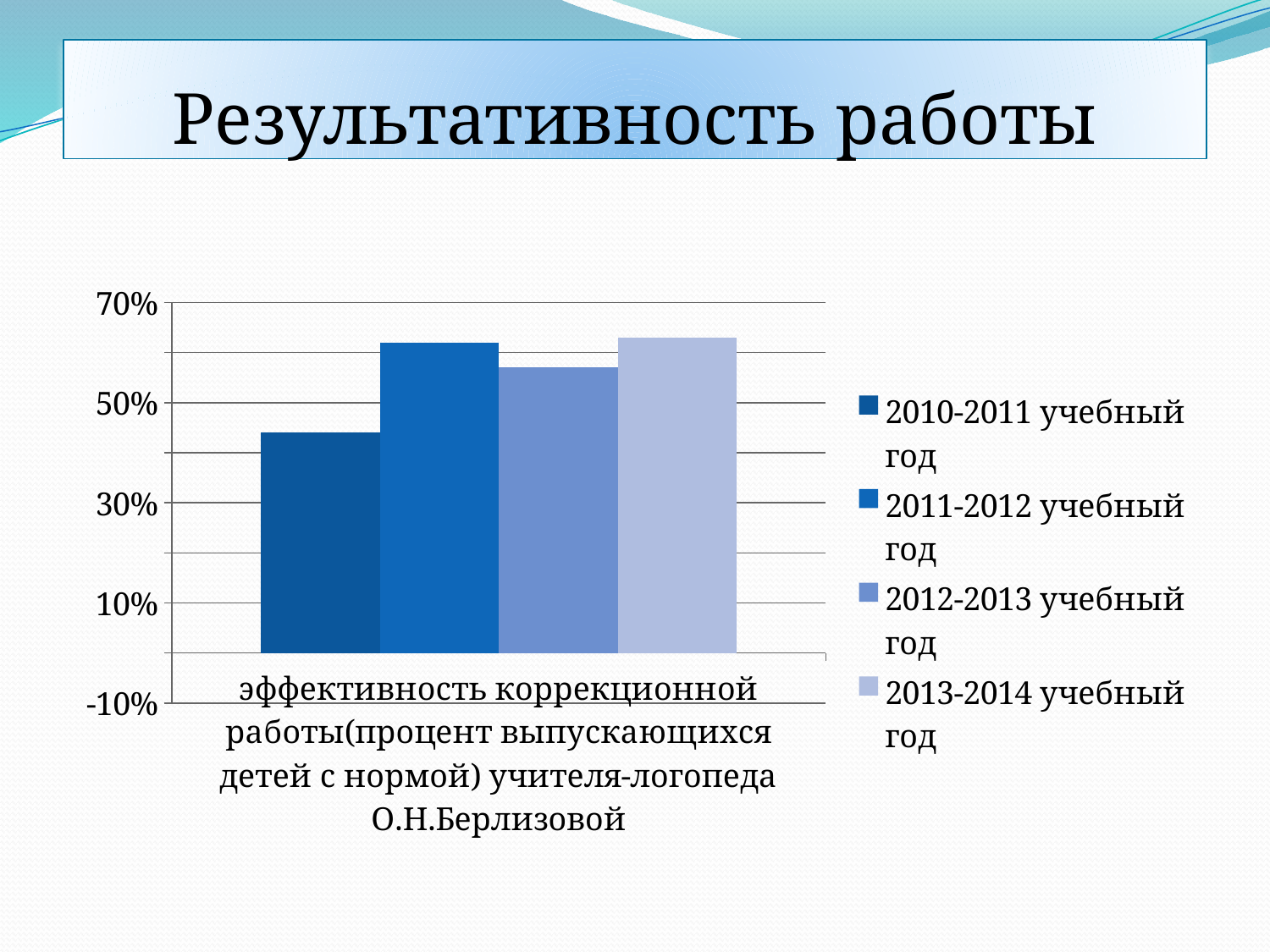
Is the value for 2013-2014 учебный год greater or less than 50%? greater Which is larger, the value for 2012-2013 учебный год or for 2010-2011 учебный год? 2012-2013 учебный год What is the title of the slide? Результативность работы How many categories are plotted on the x axis? 1 Is the value for 2011-2012 учебный год greater or less than 50%? greater Is the value for 2010-2011 учебный год greater or less than 50%? less How many series does the legend list? 4 Which school year has the lowest bar? 2010-2011 учебный год Which is larger, the value for 2010-2011 учебный год or for 2011-2012 учебный год? 2011-2012 учебный год What kind of chart is shown on the slide? bar chart